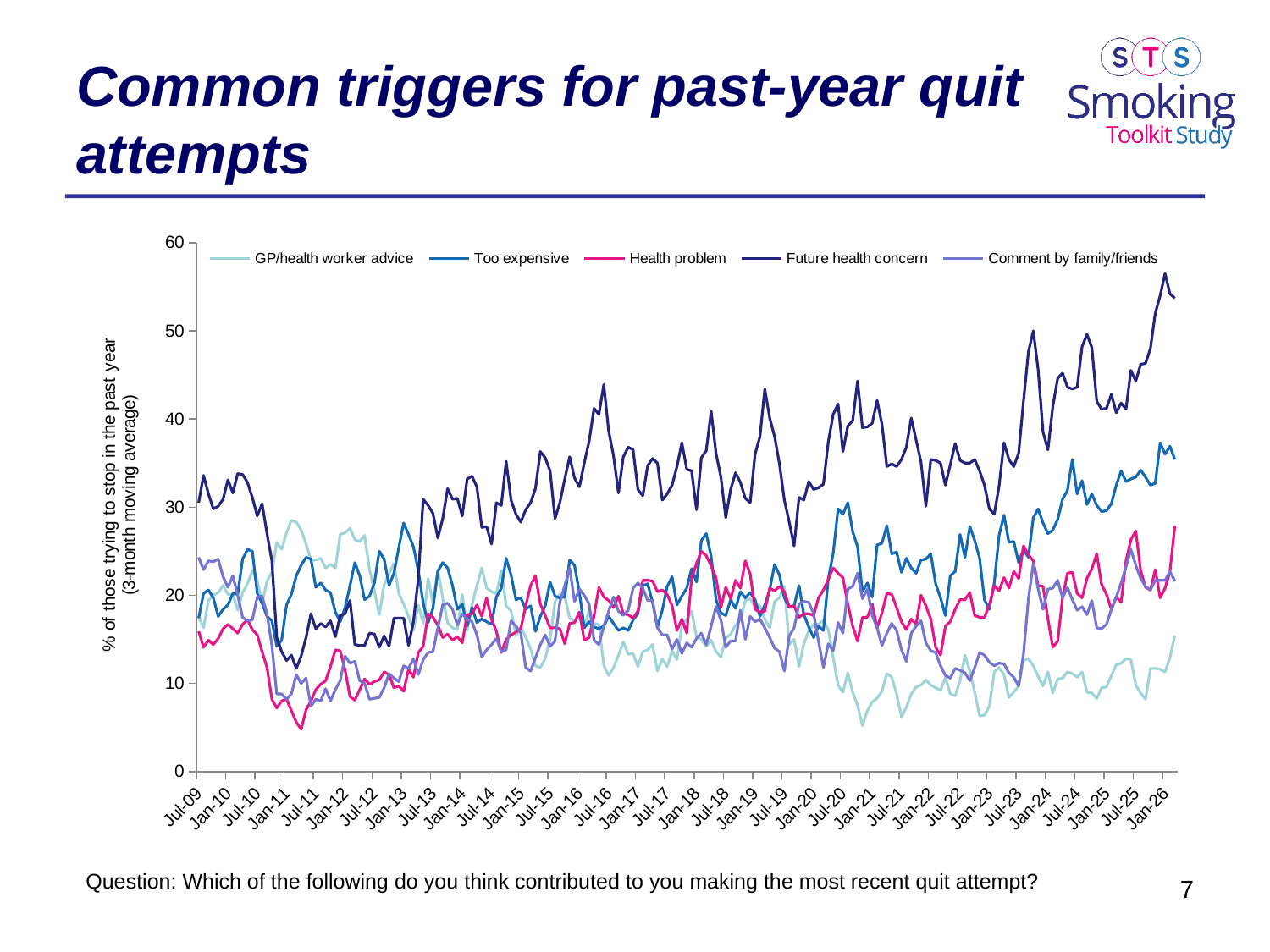
What is the title of the slide's chart? Common triggers for past-year quit attempts Which series has the highest value at Jan-26? Future health concern Is the value for Too expensive at Jan-26 greater or less than 30? greater How many series does the legend list? 5 Which series has the lowest value at Jan-26? GP/health worker advice Is the value for GP/health worker advice at Jan-26 greater or less than 20? less Is the value for Future health concern at Jan-26 greater or less than 50? greater Does the GP/health worker advice series rise or fall overall between Jan-12 and Jan-21? fall What kind of chart is shown on the slide? line chart At Jan-26, which is higher: Too expensive or Health problem? Too expensive Does the Future health concern series rise or fall overall between Jan-23 and Jan-26? rise